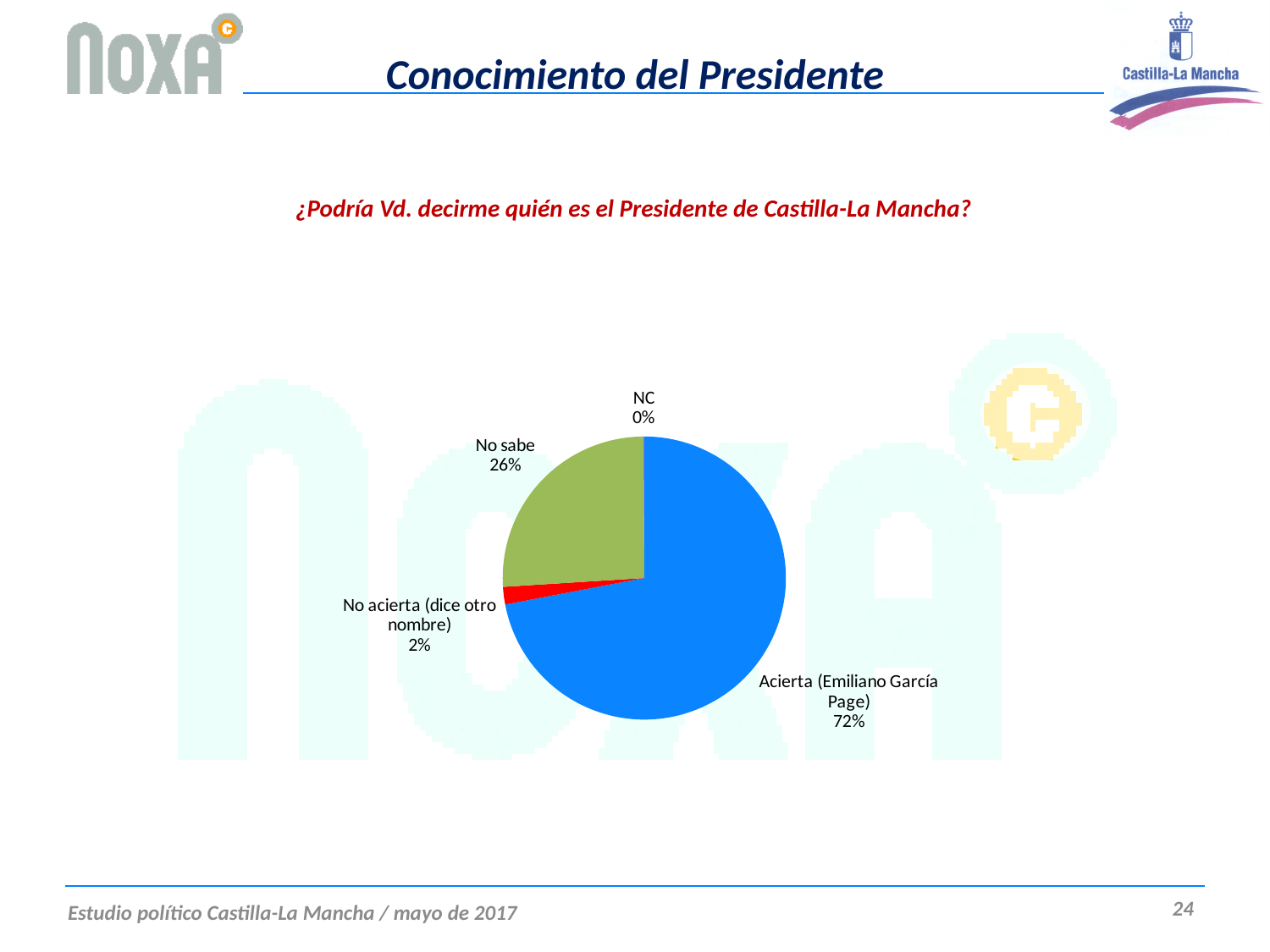
Which category has the smallest share of the pie? NC How many categories are shown in the pie chart? 4 What is the value for 'No acierta (dice otro nombre)'? 2% What question is the pie chart answering, as written above it? ¿Podría Vd. decirme quién es el Presidente de Castilla-La Mancha? What percentage of respondents correctly named Emiliano García Page as President? 72% What is the difference in percentage points between 'Acierta (Emiliano García Page)' and 'No sabe'? 46 What type of chart is shown on the slide? Pie chart Which category has the largest share of the pie? Acierta (Emiliano García Page) What is the value for the 'NC' slice? 0% What colour is the 'No sabe' slice? Green Which is larger: 'No sabe' or 'No acierta (dice otro nombre)'? No sabe What is the value for the 'No sabe' slice? 26%